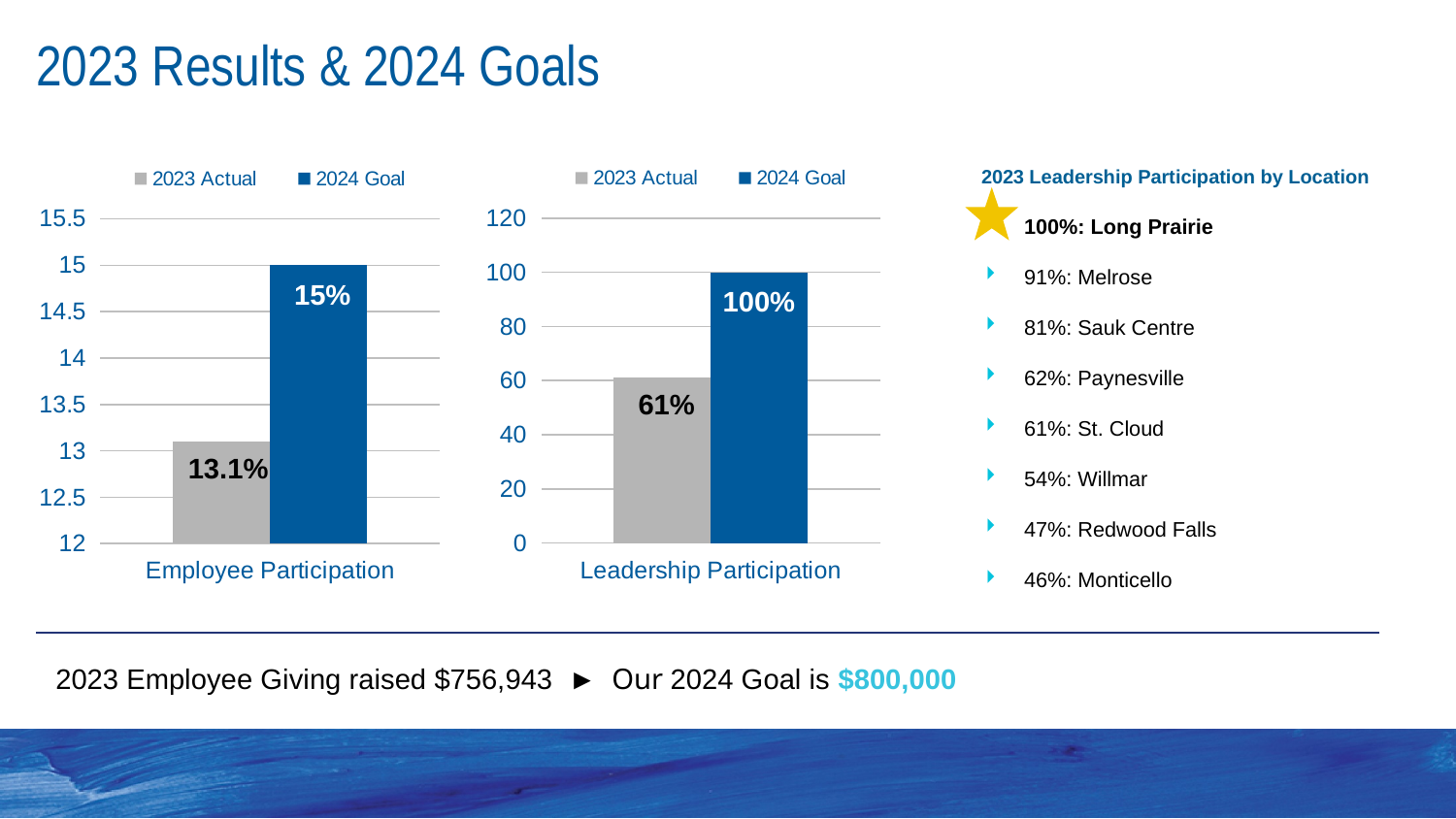
How many series does the legend of the left chart (Employee Participation) list? 2 In the left chart (Employee Participation), what is the difference between the 2024 Goal and the 2023 Actual? 1.9 percentage points What kind of chart is the middle chart (Leadership Participation)? Bar chart In the left chart (Employee Participation), which series has the larger value, 2023 Actual or 2024 Goal? 2024 Goal In the middle chart (Leadership Participation), what is the value for 2023 Actual? 61% In the left chart (Employee Participation), what colour is the 2024 Goal bar? Dark blue In the middle chart (Leadership Participation), what is the difference between the 2024 Goal and the 2023 Actual? 39 percentage points In the middle chart (Leadership Participation), is the value for 2023 Actual greater or less than 80? less In the left chart (Employee Participation), what is the value for 2024 Goal? 15% In the left chart (Employee Participation), what is the value for 2023 Actual? 13.1% In the middle chart (Leadership Participation), what is the value for 2024 Goal? 100% In the middle chart (Leadership Participation), which series has the smaller value? 2023 Actual